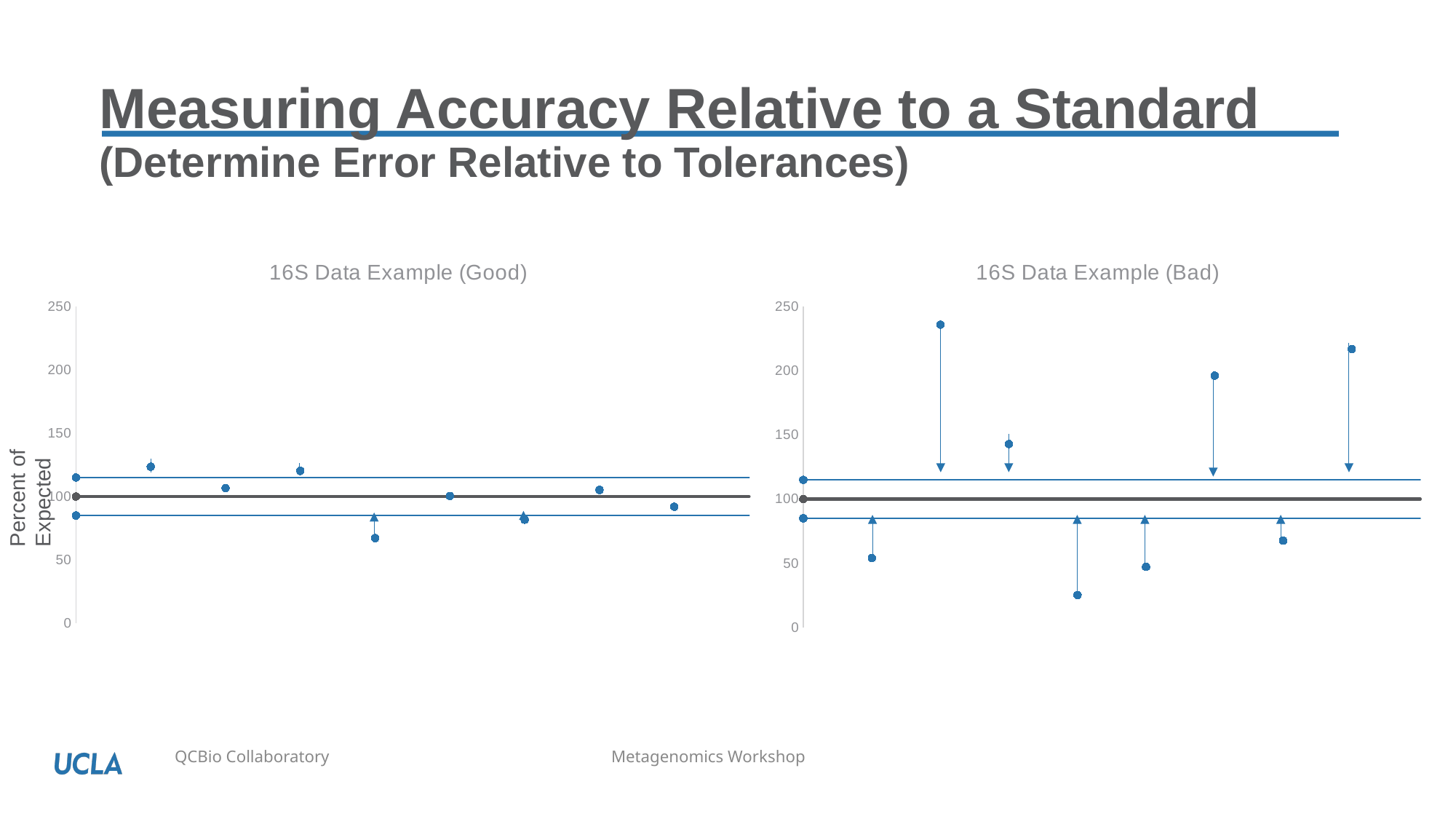
In "16S Data Example (Bad)", is the highest plotted point greater or less than 200? greater In "16S Data Example (Good)", is the highest plotted point greater or less than 150? less What kind of chart is "16S Data Example (Good)"? scatter chart What is the y-axis title shared by the two charts? Percent of Expected In "16S Data Example (Good)", is the lowest plotted point greater or less than 50? greater What is the maximum value shown on the y-axis of "16S Data Example (Good)"? 250 In "16S Data Example (Good)", how many data points are plotted? 8 In "16S Data Example (Bad)", how many data points are plotted? 8 Which chart contains the point with the highest value, "16S Data Example (Good)" or "16S Data Example (Bad)"? 16S Data Example (Bad) What kind of chart is "16S Data Example (Bad)"? scatter chart How many charts are shown on the slide? 2